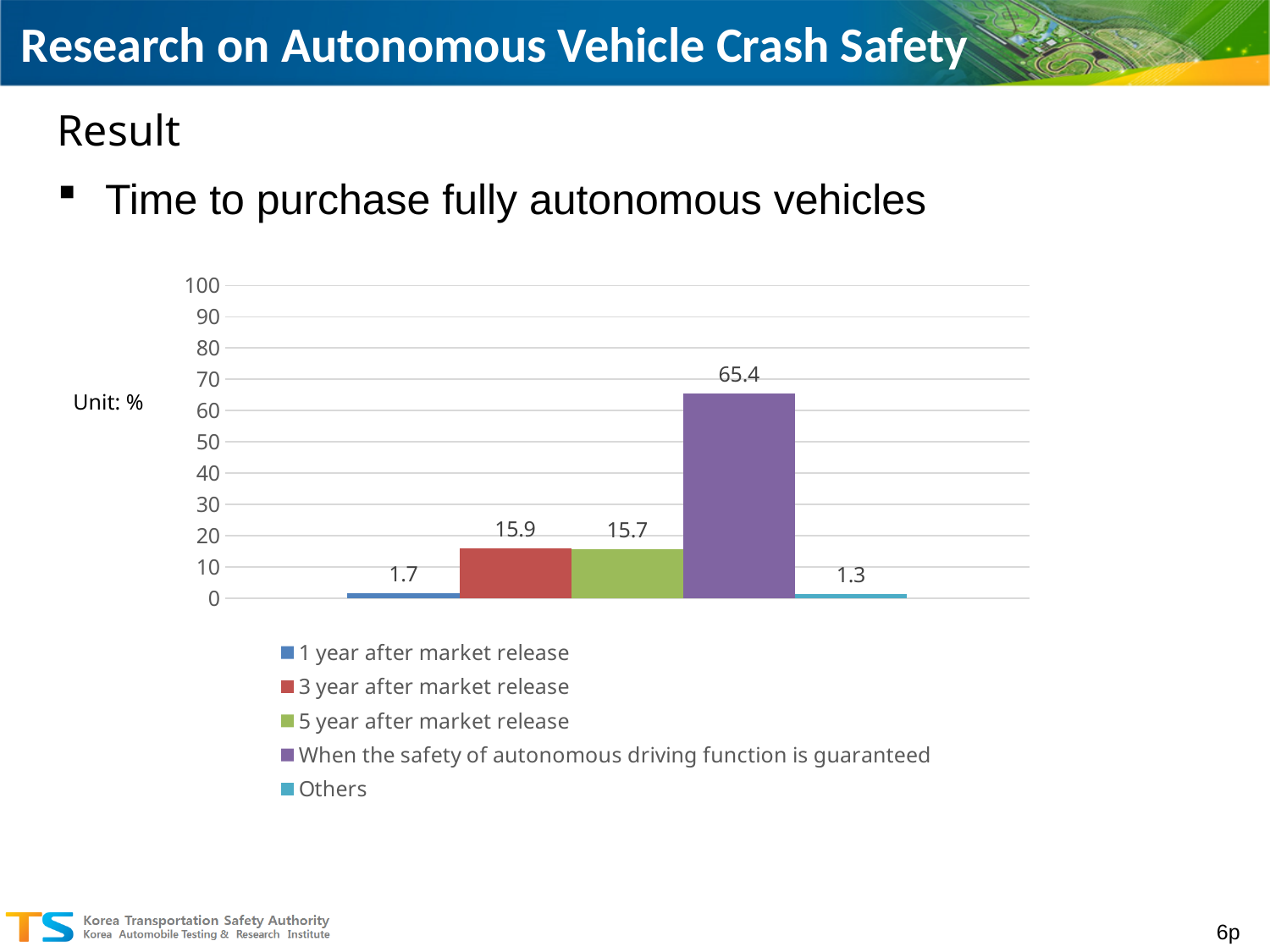
What is the value for '3 year after market release'? 15.9 What is the value for '1 year after market release'? 1.7 What is the value for 'When the safety of autonomous driving function is guaranteed'? 65.4 How many series does the legend list? 5 Is the value for 'When the safety of autonomous driving function is guaranteed' greater or less than 50? greater What is the difference between the values for 'When the safety of autonomous driving function is guaranteed' and '3 year after market release'? 49.5 Which is larger, the value for '1 year after market release' or the value for 'Others'? 1 year after market release Which series has the lowest value? Others What is the value for 'Others'? 1.3 What kind of chart is shown on the slide? bar chart What is the value for '5 year after market release'? 15.7 Which series has the highest value? When the safety of autonomous driving function is guaranteed